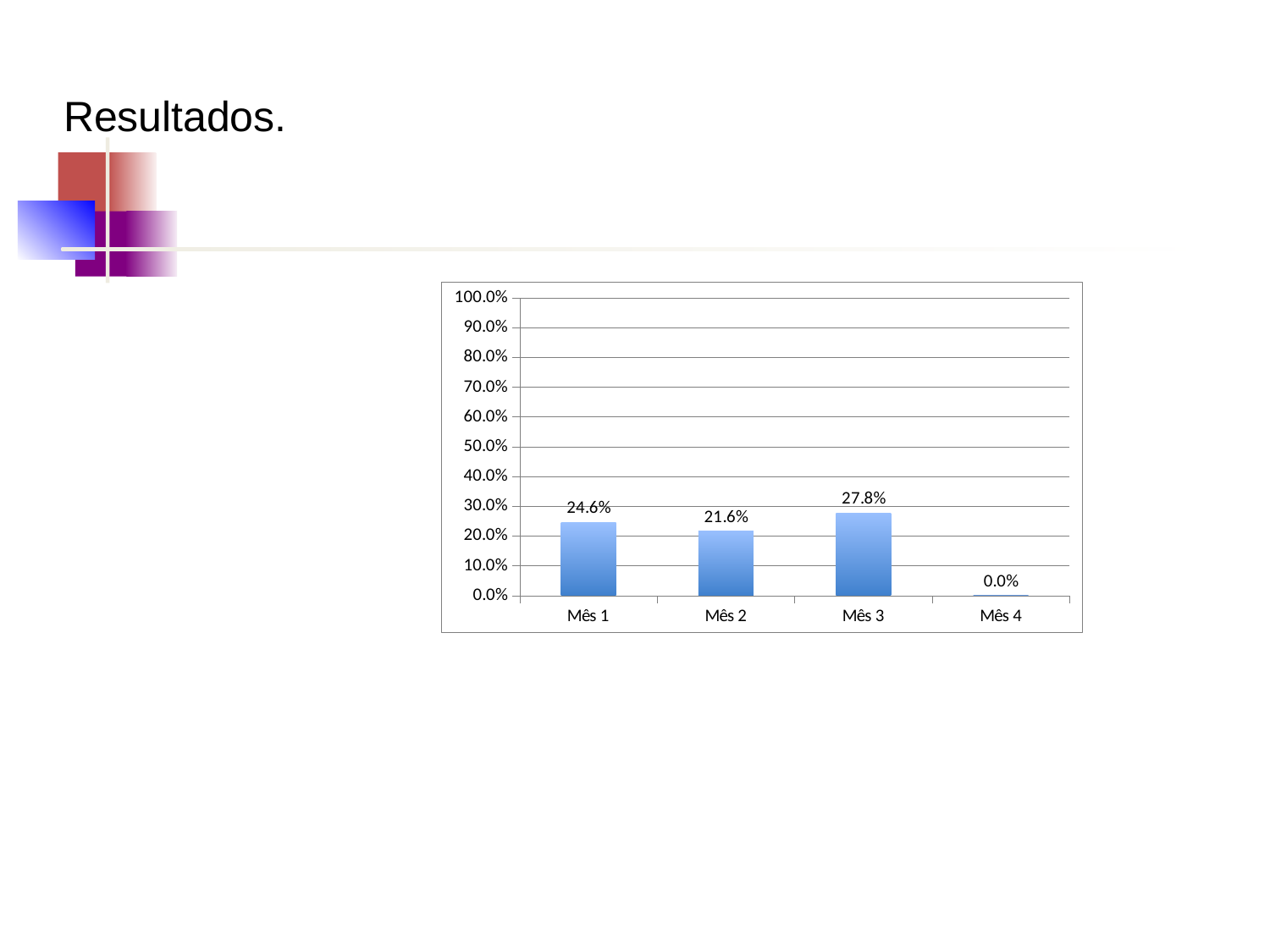
How many categories are shown on the x axis? 4 What is the value for Mês 1? 24.6% What is the value for Mês 2? 21.6% What is the value for Mês 3? 27.8% What is the difference between the values for Mês 3 and Mês 2? 6.2% What is the value for Mês 4? 0.0% Is the value for Mês 3 greater or less than 30.0%? less Which is larger, the value for Mês 1 or the value for Mês 2? Mês 1 What kind of chart is shown on the slide? bar chart Which category has the highest value? Mês 3 Which category has the lowest value? Mês 4 What is the difference between the values for Mês 1 and Mês 2? 3.0%